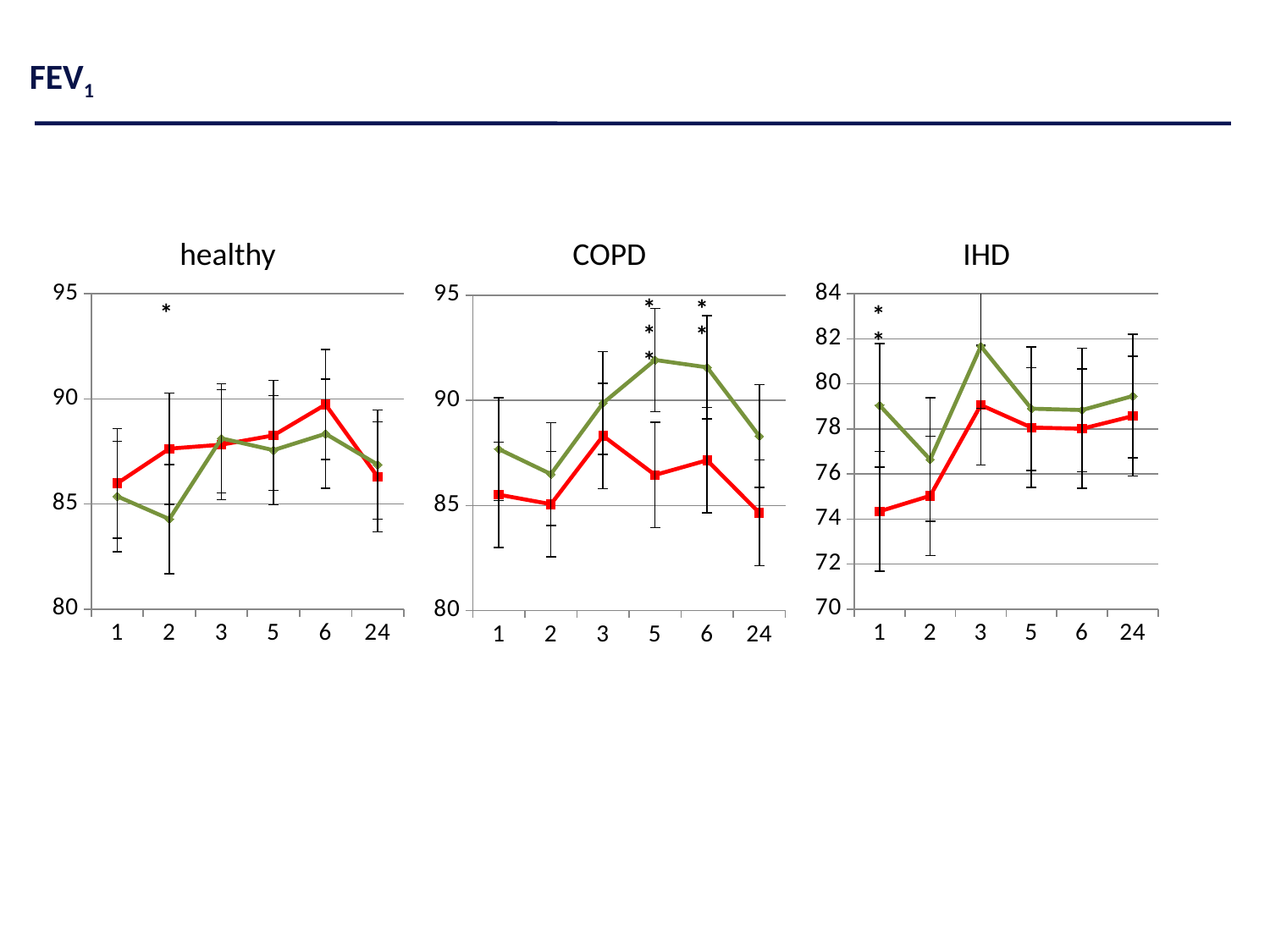
How many charts are shown on the slide? 3 In the 'healthy' chart, at which x value does the red line reach its highest point? 6 In the 'IHD' chart, is the red line's value at x = 1 greater or less than 76? less In the 'COPD' chart, is the green line's value at x = 5 greater or less than 90? greater In the 'IHD' chart, at which x value does the green line reach its highest point? 3 In the 'healthy' chart, which line is higher at x = 2, the red or the green? red In the 'COPD' chart, does the red line rise or fall from x = 6 to x = 24? fall What are the titles of the three charts on the slide? healthy, COPD, IHD How many x-axis points does the 'COPD' chart have? 6 In the 'healthy' chart, is the green line's value at x = 2 greater or less than 85? less What kind of chart is the 'healthy' chart? line chart In the 'COPD' chart, which line is higher at x = 5, the red or the green? green